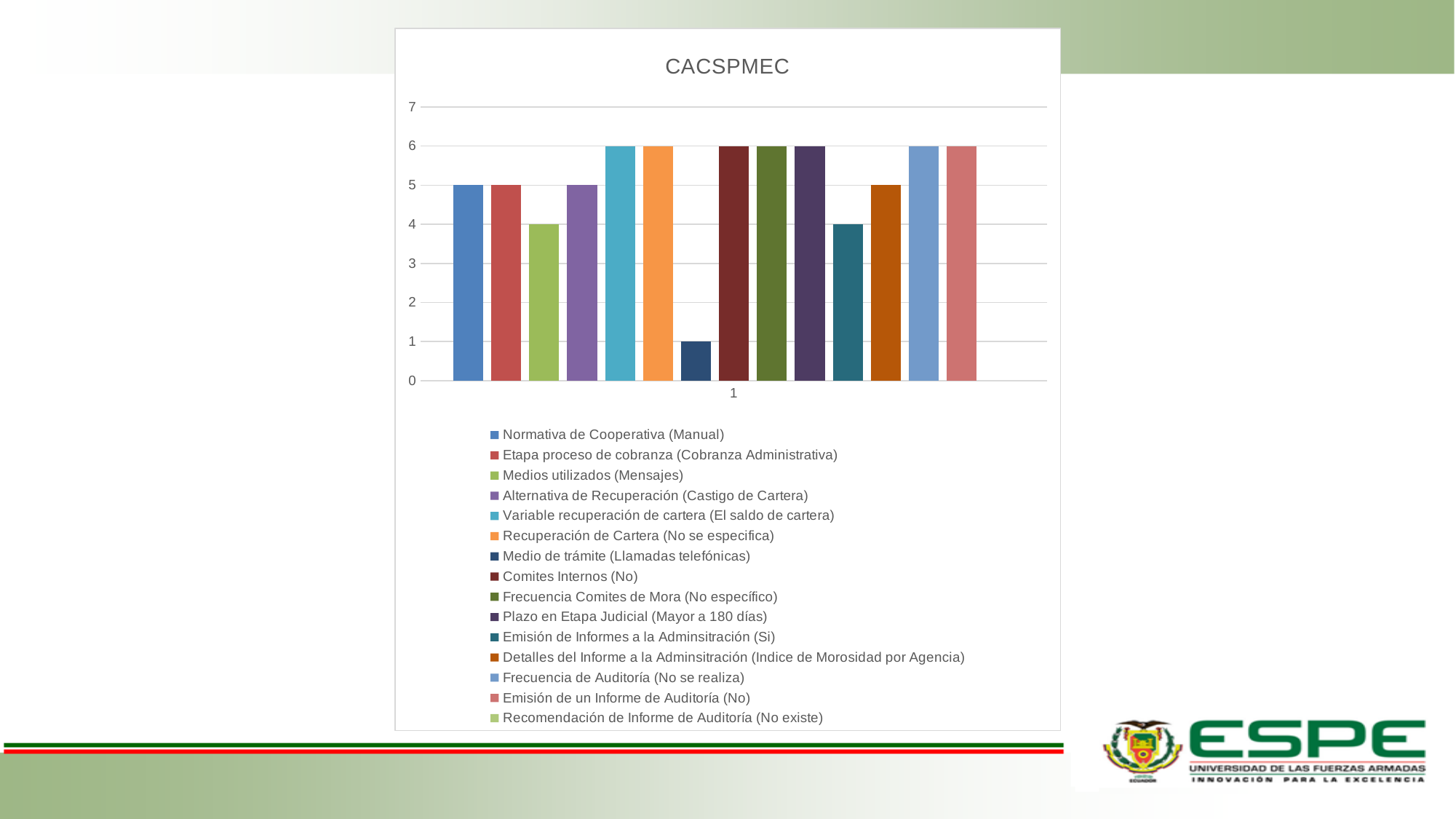
What is the difference between the values for Variable recuperación de cartera (El saldo de cartera) and Medios utilizados (Mensajes)? 2 How many series does the legend list? 15 What type of chart is shown on the slide? Bar chart What is the value for Medios utilizados (Mensajes)? 4 What is the value for Variable recuperación de cartera (El saldo de cartera)? 6 What is the value for Normativa de Cooperativa (Manual)? 5 What is the title of the chart? CACSPMEC What is the value for Detalles del Informe a la Adminsitración (Indice de Morosidad por Agencia)? 5 Which is larger, the value for Normativa de Cooperativa (Manual) or the value for Medio de trámite (Llamadas telefónicas)? Normativa de Cooperativa (Manual) Which series has the lowest value? Medio de trámite (Llamadas telefónicas) Is the value for Medio de trámite (Llamadas telefónicas) greater or less than 3? less What is the value for Medio de trámite (Llamadas telefónicas)? 1